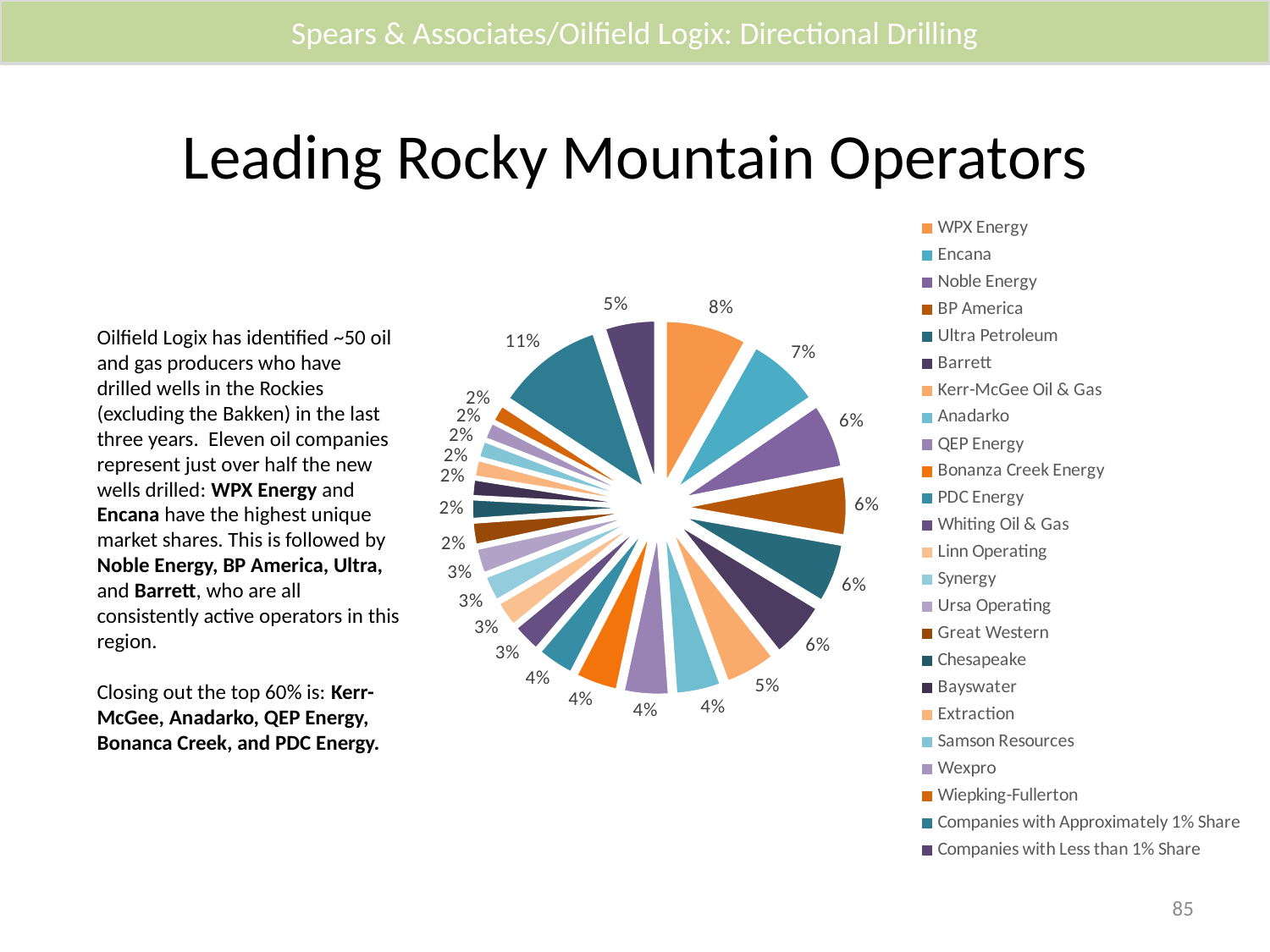
What share of the pie is labelled for Companies with Less than 1% Share? 5% What is the title of the chart slide? Leading Rocky Mountain Operators Which is larger, the slice for WPX Energy or the slice for Encana? WPX Energy What is the difference between the WPX Energy share and the Encana share? 1% What share of the pie does Noble Energy hold? 6% Which legend entry has the largest slice of the pie? Companies with Approximately 1% Share What share of the pie does Encana hold? 7% What share of the pie does Kerr-McGee Oil & Gas hold? 5% How much larger is the share for Companies with Approximately 1% Share than the share for WPX Energy? 3% How many entries does the chart legend list? 24 What share of the pie does WPX Energy hold? 8% What kind of chart is shown on the slide? pie chart